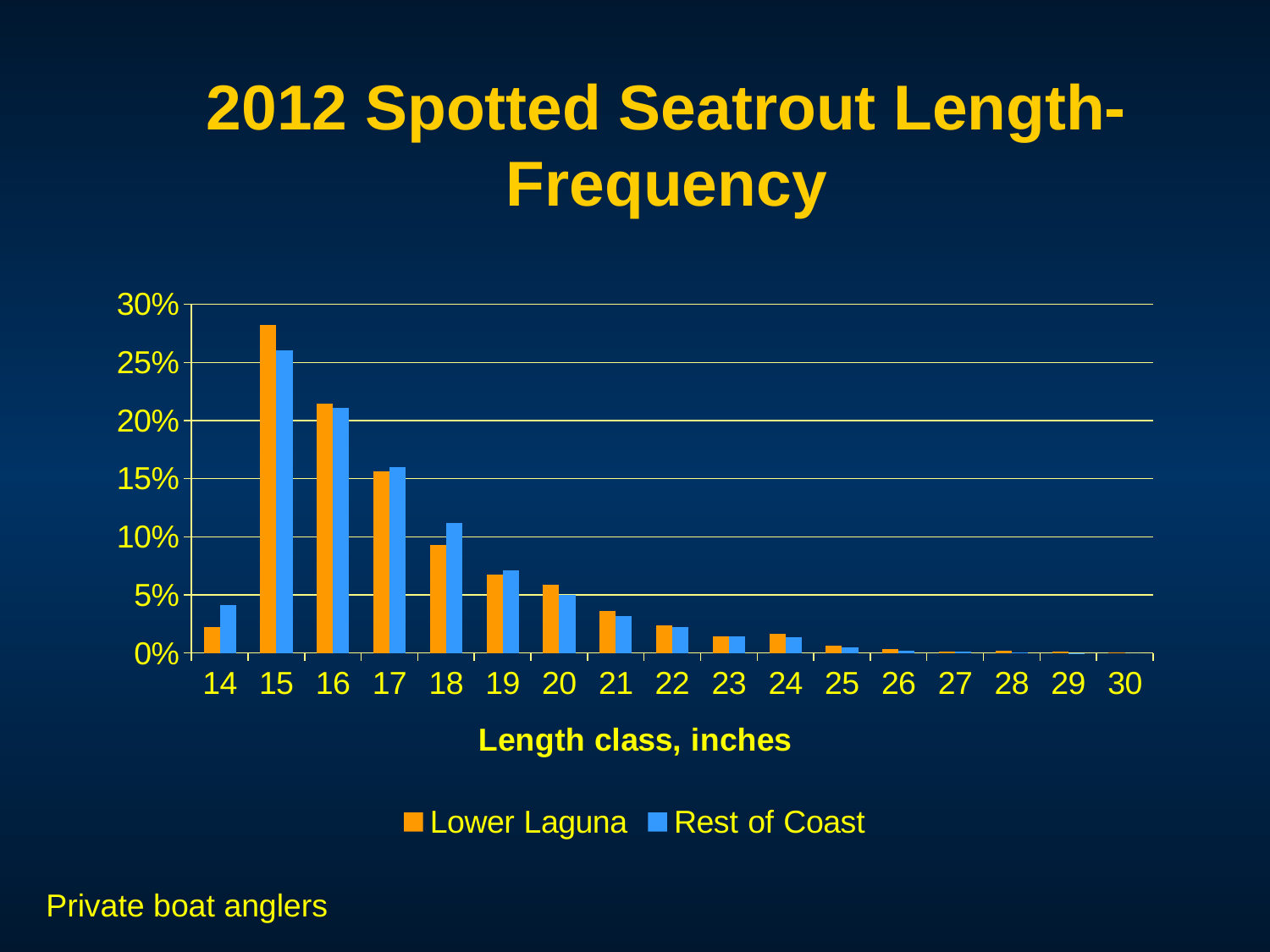
What kind of chart is shown on the slide? bar chart For length class 14, which series has the larger value, Lower Laguna or Rest of Coast? Rest of Coast For length class 15, which series has the larger value, Lower Laguna or Rest of Coast? Lower Laguna Which length class has the highest value for Rest of Coast? 15 Is the Lower Laguna value for length class 18 greater or less than 10%? less Which length class has the highest value for Lower Laguna? 15 Is the Lower Laguna value for length class 15 greater or less than 25%? greater How many series does the legend list? 2 From length class 15 to length class 30, do the Lower Laguna values rise or fall? fall Is the Rest of Coast value for length class 18 greater or less than 10%? greater How many length classes are shown on the x axis? 17